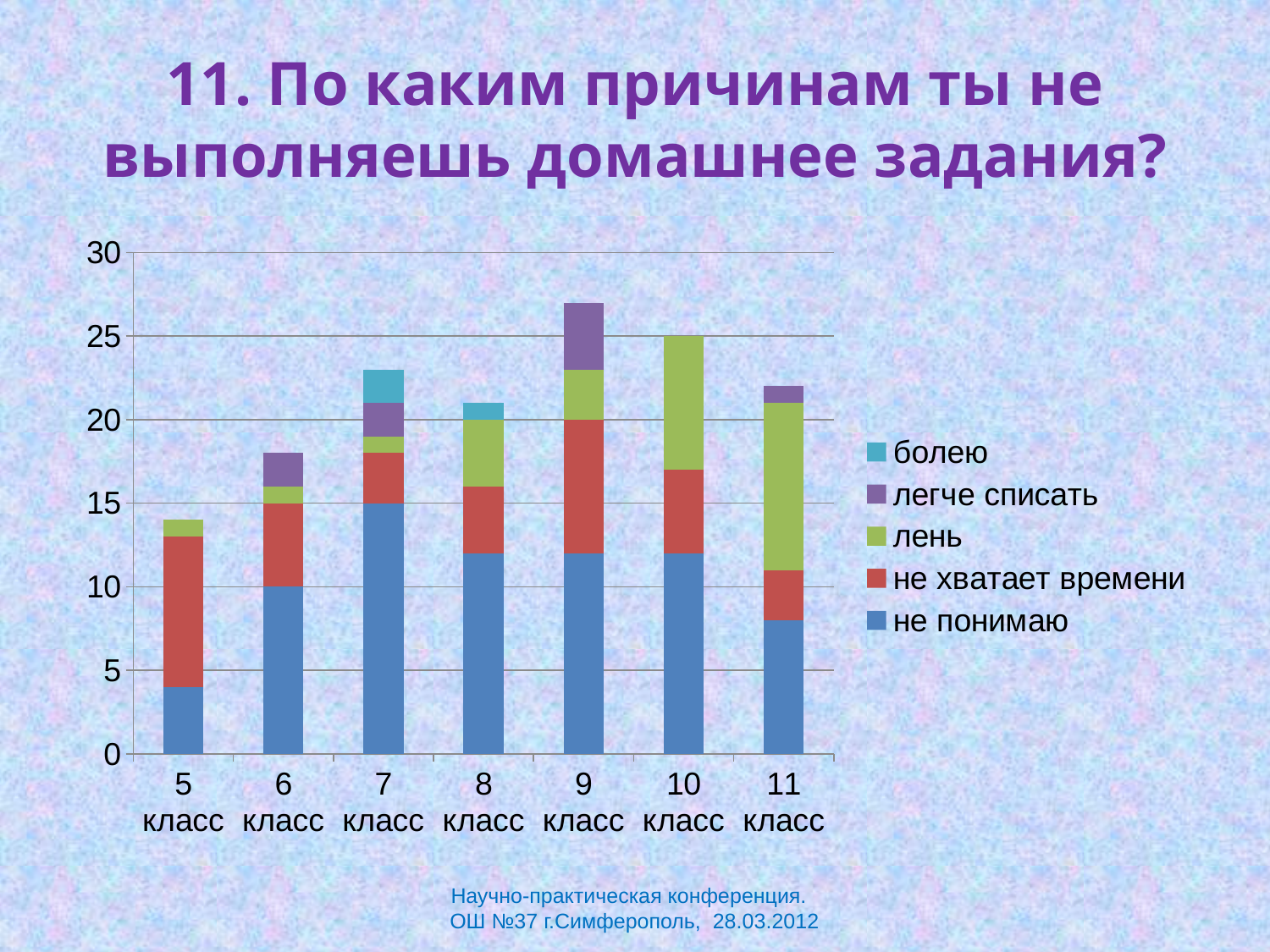
Which series is shown in green in the legend? лень Which class has the tallest stacked bar overall? 9 класс Is the total bar height for 9 класс greater or less than 25? greater Which series is listed last in the legend? не понимаю How many series does the legend list? 5 Is the total bar height for 5 класс greater or less than 15? less Is the total bar height for 11 класс greater or less than 20? greater What kind of chart is shown on the slide? stacked bar chart How many classes (categories) are shown on the x axis? 7 Which class has the shortest stacked bar overall? 5 класс Which class has a larger total bar: 7 класс or 5 класс? 7 класс